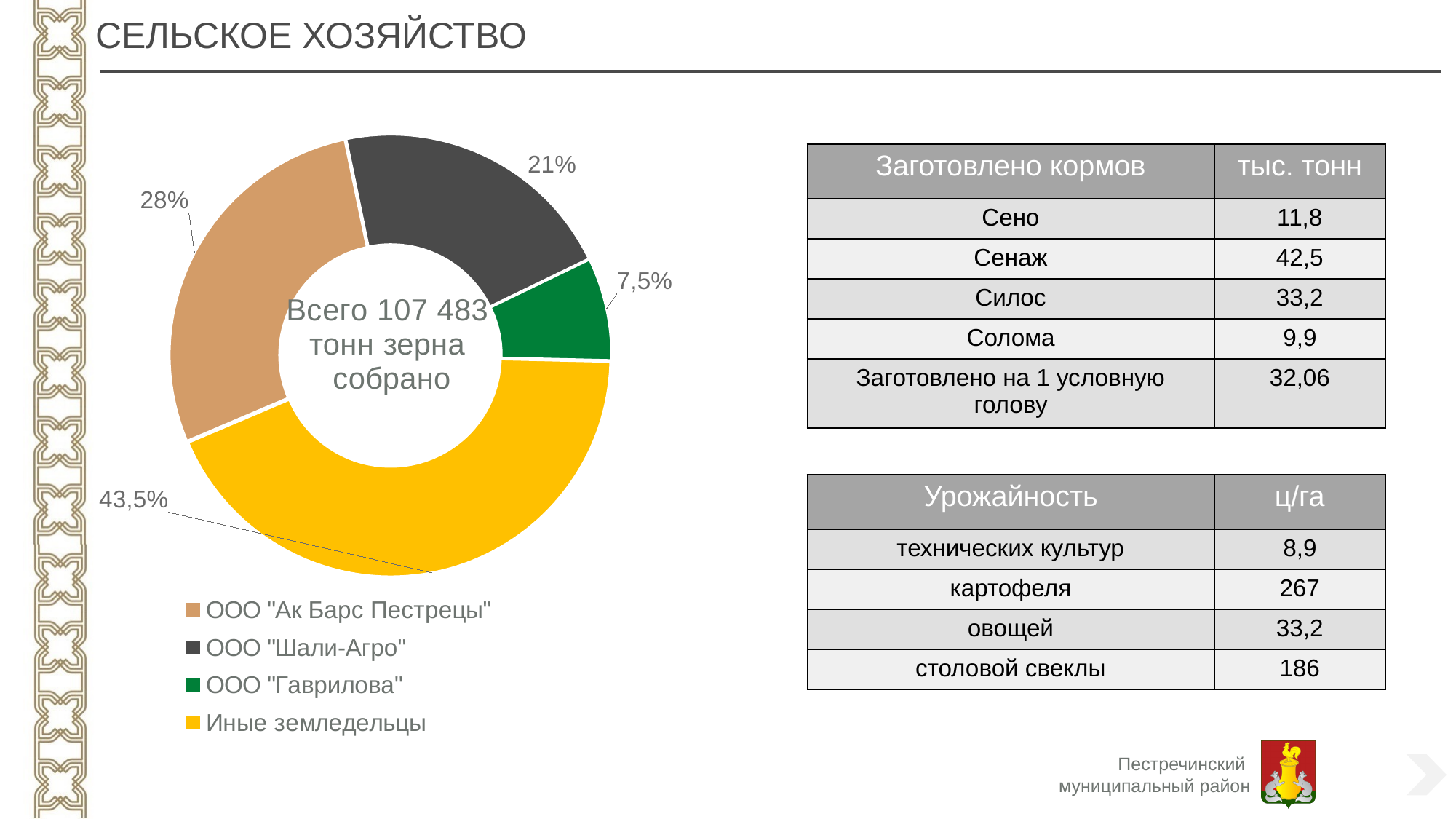
Which is larger in the pie chart: the share of ООО "Ак Барс Пестрецы" or the share of ООО "Шали-Агро"? ООО "Ак Барс Пестрецы" What share of the pie chart does Иные земледельцы have? 43,5% Which category has the largest slice in the pie chart? Иные земледельцы How many categories does the pie chart show? 4 What share of the pie chart does ООО "Гаврилова" have? 7,5% What total is stated in the centre of the pie chart? Всего 107 483 тонн зерна собрано Which category has the smallest slice in the pie chart? ООО "Гаврилова" What colour is the slice for Иные земледельцы in the pie chart? Yellow What kind of chart is shown on the slide? Pie chart (donut) What is the difference in percentage points between the shares of Иные земледельцы and ООО "Ак Барс Пестрецы" in the pie chart? 15,5 What share of the pie chart does ООО "Ак Барс Пестрецы" have? 28%